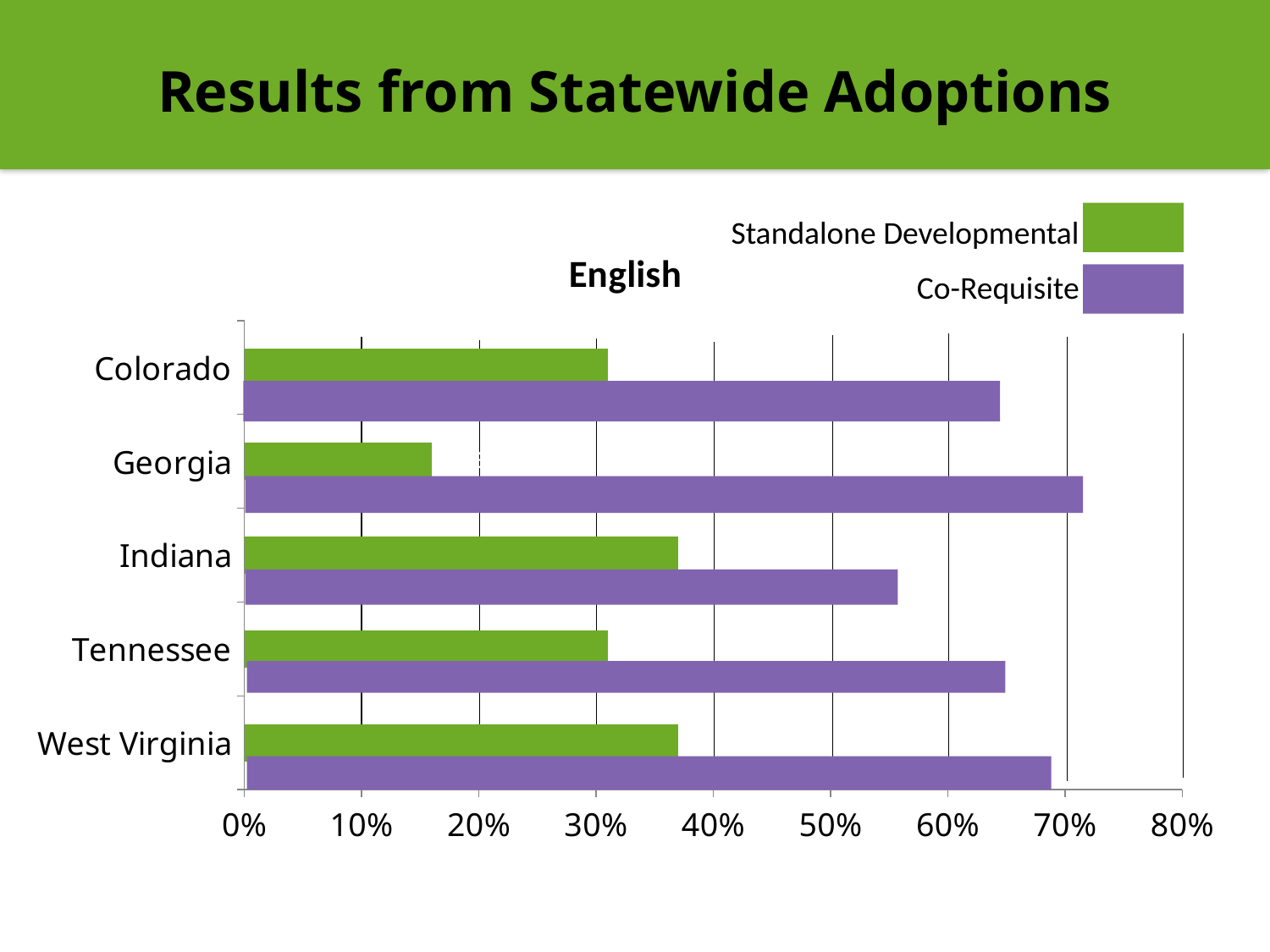
What subject does the chart's title say the results are for? English For Colorado, which is larger: the Standalone Developmental value or the Co-Requisite value? Co-Requisite Which state has the highest Co-Requisite value? Georgia Which state has the lowest Co-Requisite value? Indiana Is the Co-Requisite value for Indiana greater or less than 50%? greater Which state has the lowest Standalone Developmental value? Georgia How many series does the legend list? 2 How many states are shown on the chart? 5 Is the Co-Requisite value for Georgia greater or less than 70%? greater Is the Standalone Developmental value for West Virginia greater or less than 40%? less What kind of chart is shown on the slide? bar chart